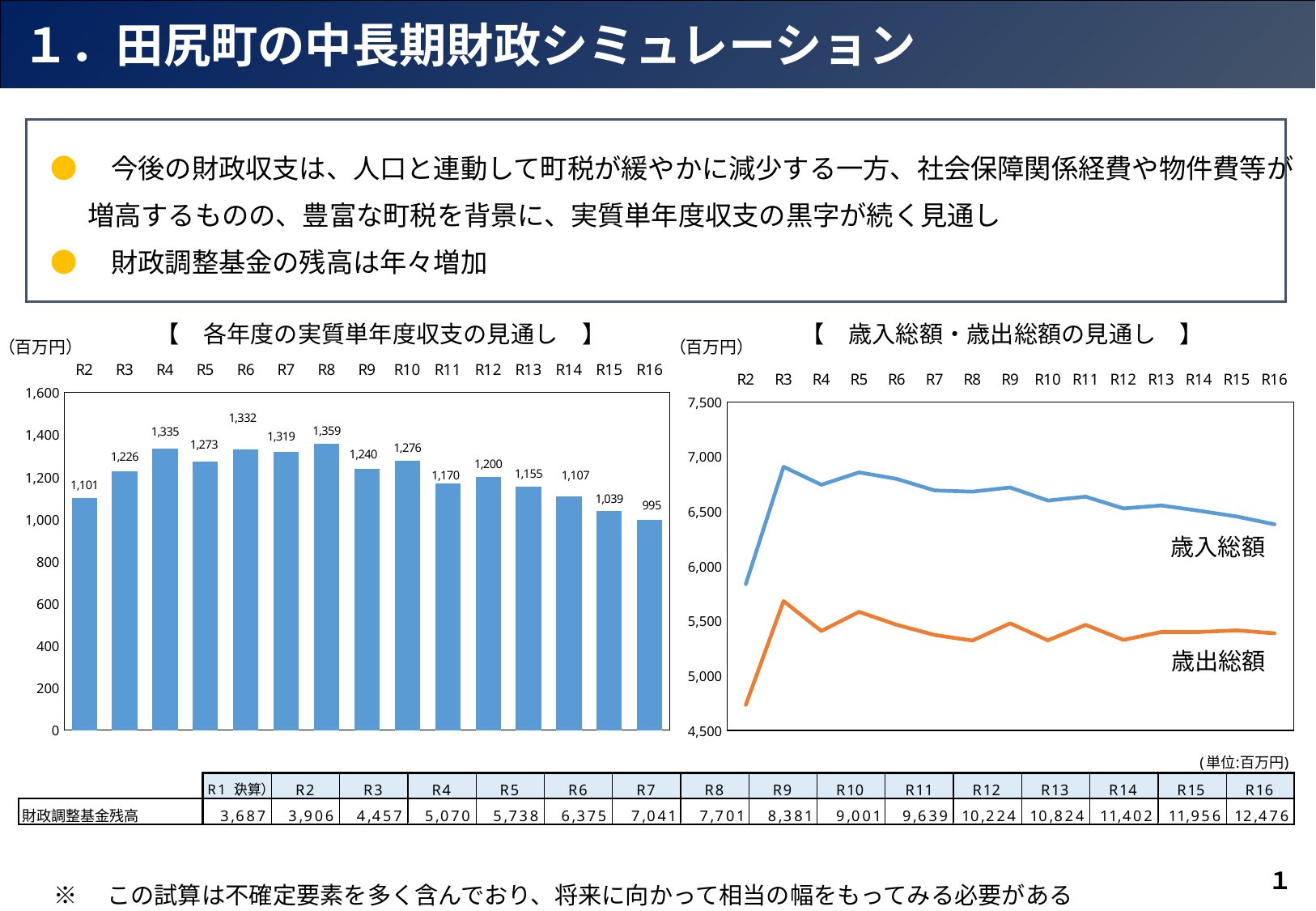
In the bar chart 各年度の実質単年度収支の見通し, what is the value for R8? 1,359 In the bar chart 各年度の実質単年度収支の見通し, what is the difference between the values for R4 and R2? 234 In the line chart 歳入総額・歳出総額の見通し, which series is higher at R10, 歳入総額 or 歳出総額? 歳入総額 In the line chart 歳入総額・歳出総額の見通し, is the value of 歳入総額 for R2 greater or less than 6,000? less In the bar chart 各年度の実質単年度収支の見通し, which year has the highest value? R8 What kind of chart is the left chart 各年度の実質単年度収支の見通し? Bar chart In the bar chart 各年度の実質単年度収支の見通し, what is the value for R16? 995 In the bar chart 各年度の実質単年度収支の見通し, which is larger, the value for R6 or the value for R7? R6 In the line chart 歳入総額・歳出総額の見通し, how many series are plotted? 2 How many years are plotted in the bar chart 各年度の実質単年度収支の見通し? 15 In the bar chart 各年度の実質単年度収支の見通し, which year has the lowest value? R16 In the line chart 歳入総額・歳出総額の見通し, is the value of 歳出総額 for R3 greater or less than 5,500? greater